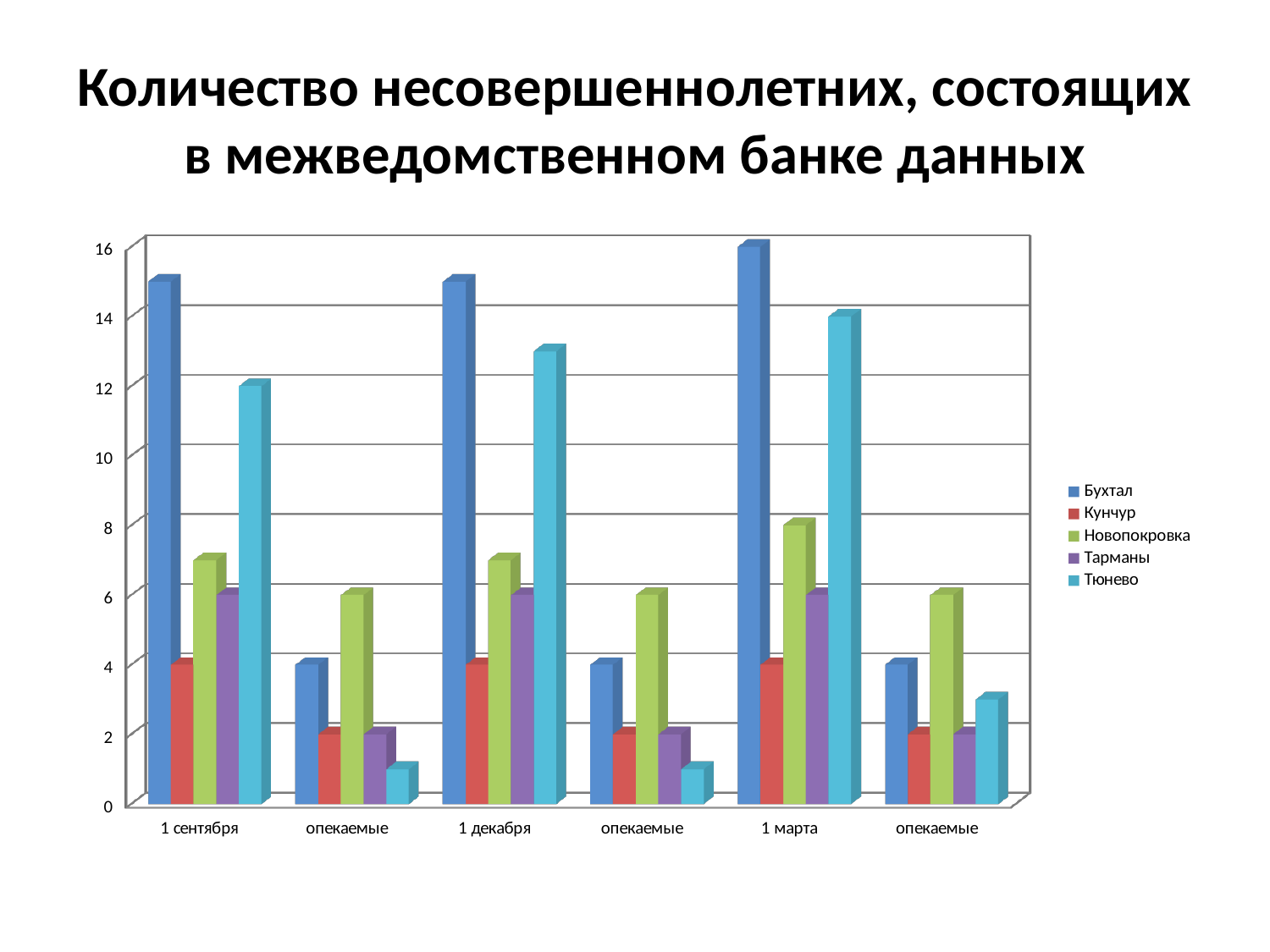
Which series has the lowest value at 1 сентября? Кунчур What is the difference between Бухтал and Кунчур at 1 марта? 12 How many categories are shown along the x axis? 6 What kind of chart is shown on the slide? Bar chart What is the value for Бухтал at 1 марта? 16 At 1 марта, which is larger: Новопокровка or Тарманы? Новопокровка Is the value for Тюнево at 1 декабря greater or less than 12? greater How many series does the legend list? 5 Is the value for Бухтал at 1 сентября greater or less than 14? greater What is the value for Тюнево at 1 сентября? 12 Which series has the highest value at 1 марта? Бухтал What is the value for Кунчур at 1 сентября? 4